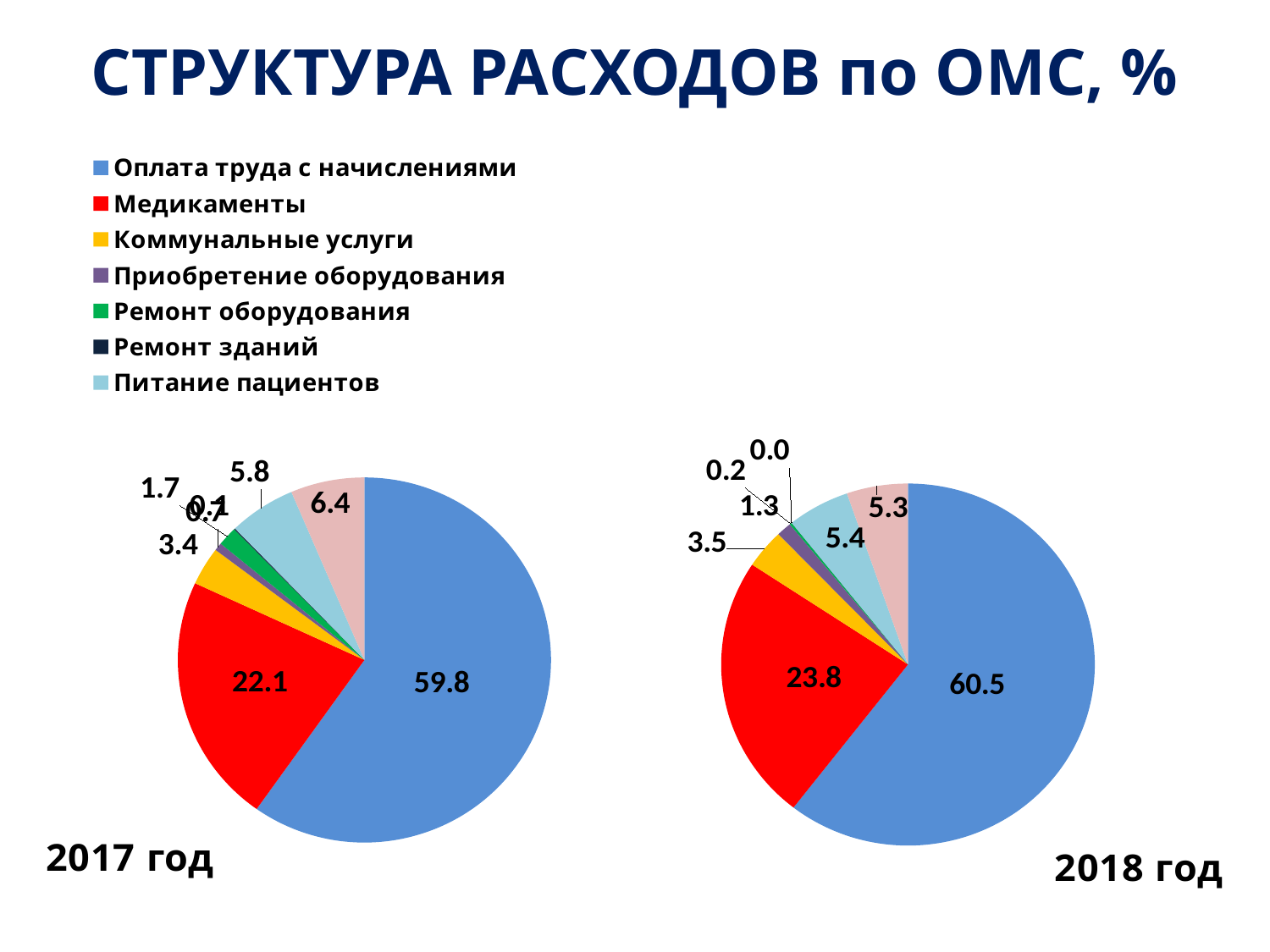
In the 2018 год pie chart, what is the value for Питание пациентов? 5.4 In the 2017 год pie chart, what is the value for Оплата труда с начислениями? 59.8 How many categories does the legend list? 7 What type of charts are shown on the slide? Pie charts In the 2018 год pie chart, which category has the largest share? Оплата труда с начислениями In the 2017 год pie chart, what is the value for Питание пациентов? 5.8 In the 2018 год pie chart, what is the value for Коммунальные услуги? 3.5 In the 2018 год pie chart, what is the value for Оплата труда с начислениями? 60.5 By how much did the share of Оплата труда с начислениями change from the 2017 год chart to the 2018 год chart? 0.7 Is the share of Медикаменты larger in the 2017 год chart or the 2018 год chart? 2018 год In the 2018 год pie chart, what is the value for Медикаменты? 23.8 In the 2017 год pie chart, what is the value for Медикаменты? 22.1